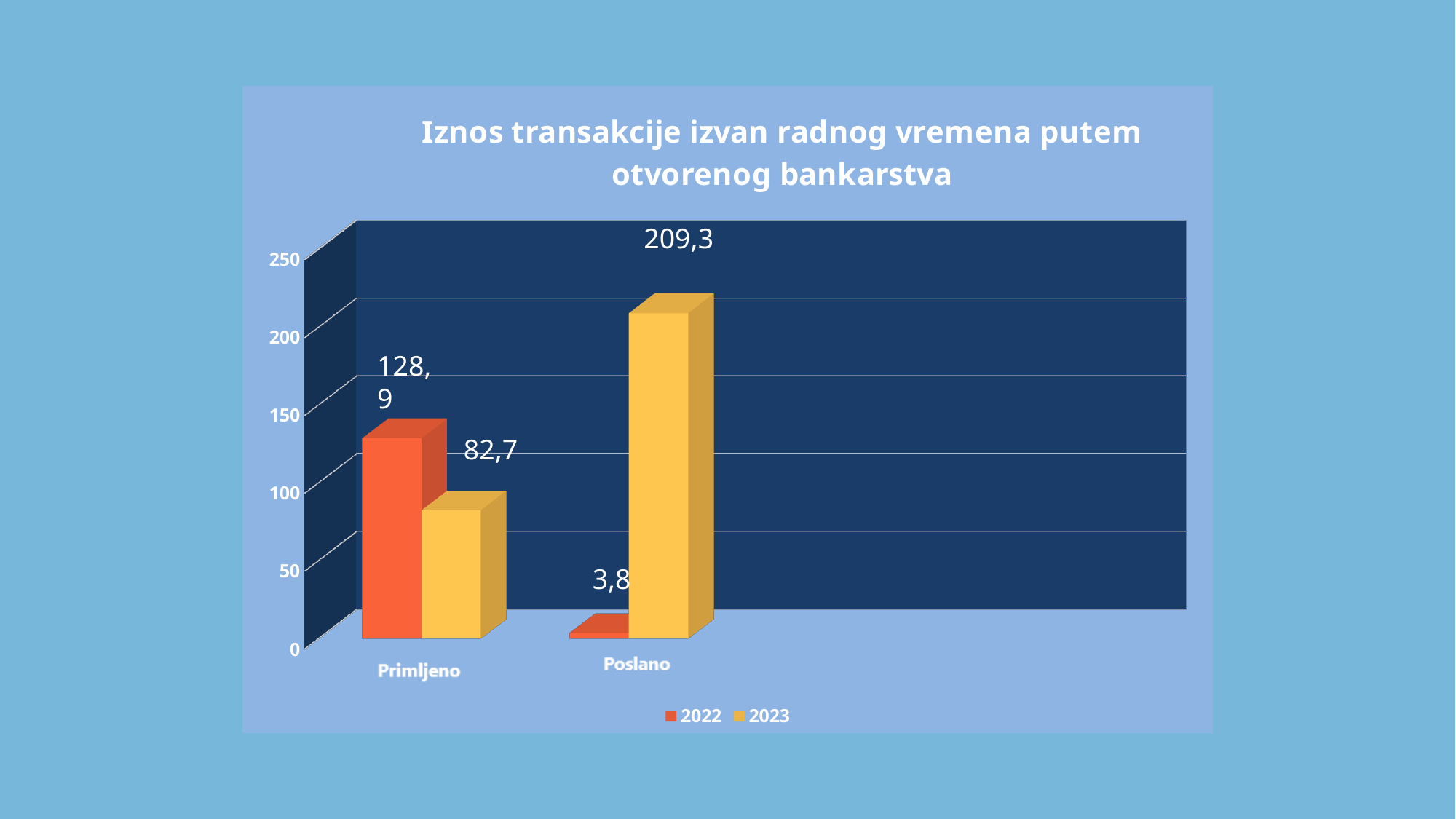
How many series does the legend list? 2 What is the difference between the 2022 and 2023 values for Primljeno? 46,2 How many categories are shown on the x axis? 2 What is the value for Primljeno in the 2022 series? 128,9 What is the difference between the 2023 and 2022 values for Poslano? 205,5 Which category has the lowest value in the 2022 series? Poslano What kind of chart is shown on the slide? Bar chart What is the value for Poslano in the 2022 series? 3,8 What is the value for Primljeno in the 2023 series? 82,7 Which category has the highest value in the 2023 series? Poslano Which is larger for Primljeno: the 2022 value or the 2023 value? 2022 What is the value for Poslano in the 2023 series? 209,3